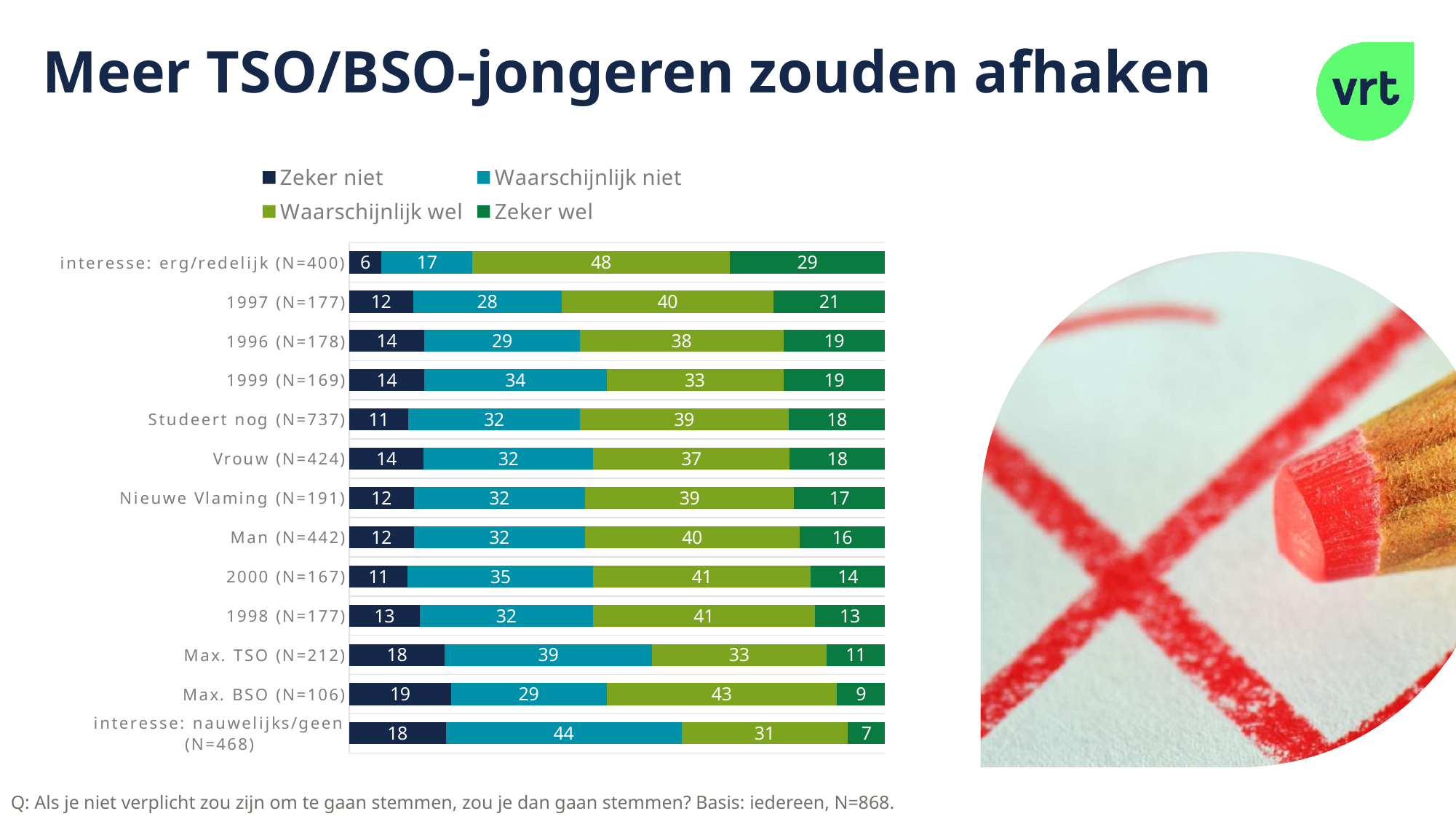
What is the difference between the "Zeker wel" values for "1997 (N=177)" and "1998 (N=177)"? 8 How many series does the legend list? 4 Which category has the highest value for "Waarschijnlijk wel"? interesse: erg/redelijk (N=400) What is the value for "Zeker wel" for the category "interesse: erg/redelijk (N=400)"? 29 Which legend entry is shown in the darkest blue colour? Zeker niet What is the value for "Waarschijnlijk niet" for the category "Max. TSO (N=212)"? 39 What kind of chart is shown on the slide? Stacked bar chart Which category has the lowest value for "Zeker wel"? interesse: nauwelijks/geen (N=468) Which is larger: the "Waarschijnlijk niet" value for "Max. TSO (N=212)" or for "Max. BSO (N=106)"? Max. TSO (N=212) How many categories are shown on the chart? 13 What is the total of the stacked bar for "interesse: nauwelijks/geen (N=468)"? 100 What is the value for "Zeker niet" for the category "Max. BSO (N=106)"? 19